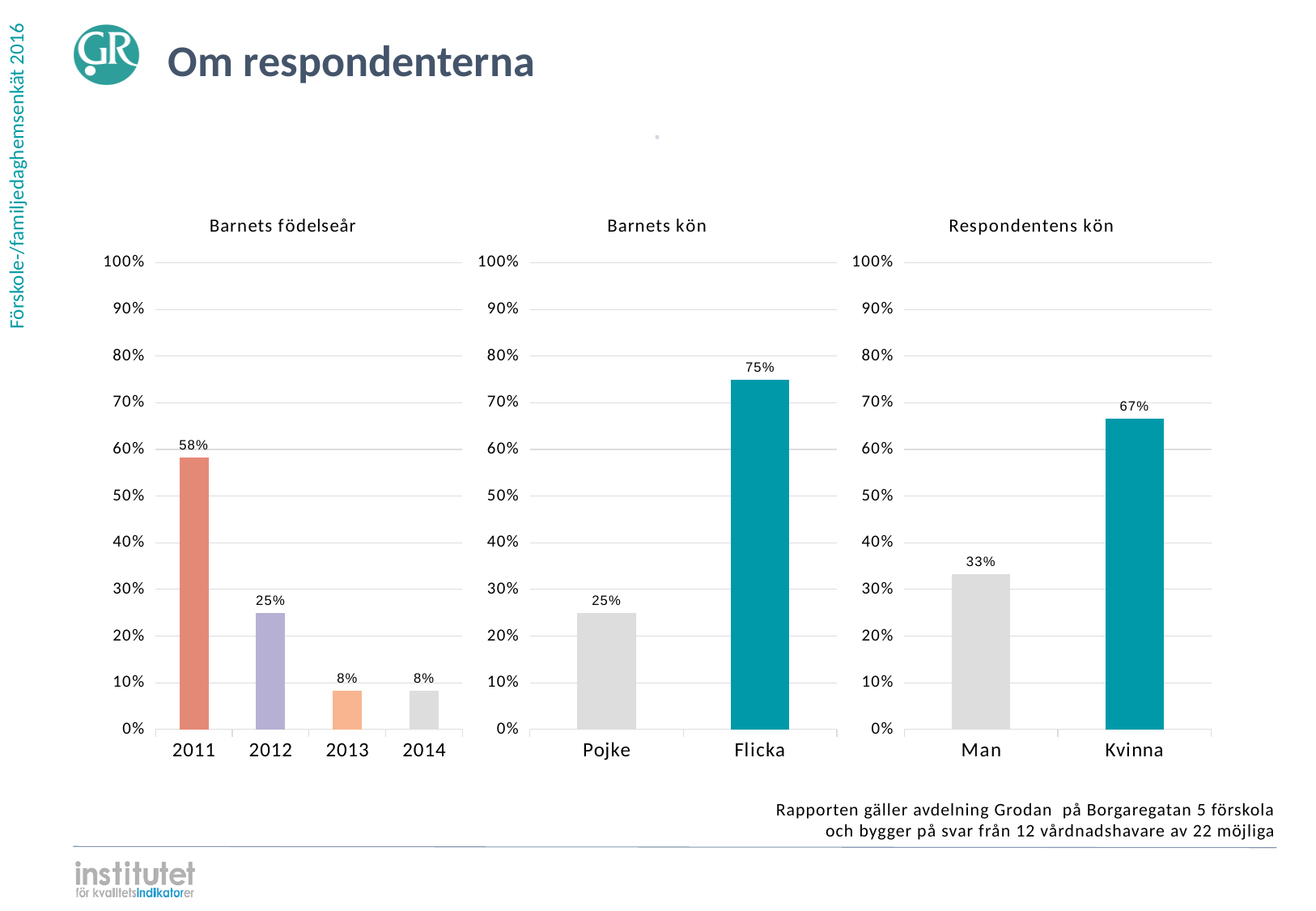
In the 'Barnets födelseår' chart, what is the value for 2011? 58% In the 'Respondentens kön' chart, what is the value for Man? 33% In the 'Barnets kön' chart, which category has the lowest value? Pojke In the 'Barnets födelseår' chart, do the values rise or fall from 2011 to 2014? fall In the 'Barnets födelseår' chart, which year has the highest value? 2011 In the 'Barnets kön' chart, what is the difference between Flicka and Pojke? 50% In the 'Barnets kön' chart, what is the value for Flicka? 75% In the 'Barnets födelseår' chart, how many years are shown on the x axis? 4 What kind of chart is the 'Respondentens kön' chart? bar chart In the 'Respondentens kön' chart, which is larger, Man or Kvinna? Kvinna In the 'Respondentens kön' chart, is the value for Kvinna greater or less than 60%? greater In the 'Barnets födelseår' chart, what is the difference between the values for 2011 and 2012? 33%